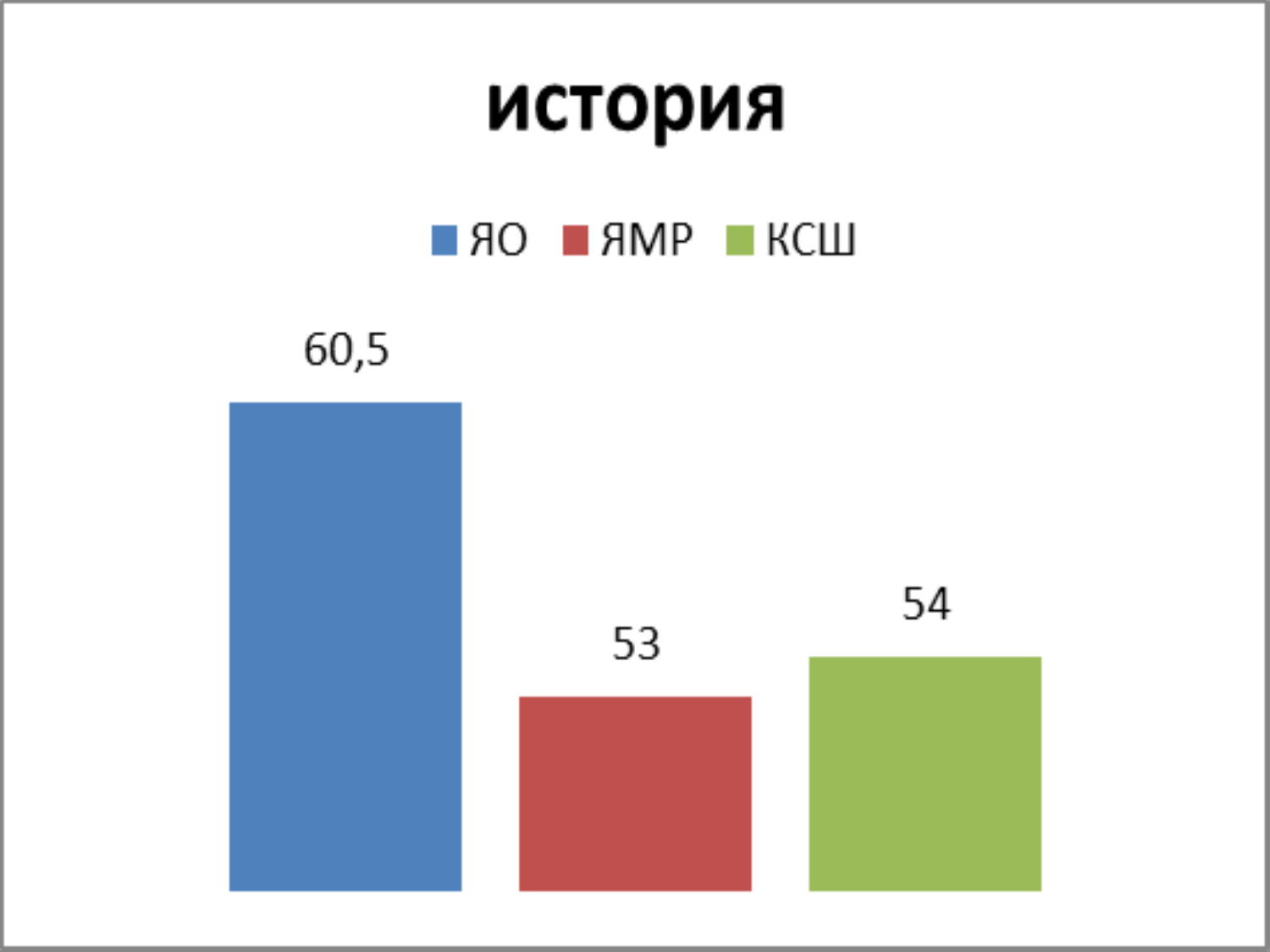
What is the value for ЯМР? 53 What is the title of the chart? история Which category has the highest value? ЯО What is the difference between the values for КСШ and ЯМР? 1 What is the value for ЯО? 60,5 What is the difference between the values for ЯО and ЯМР? 7,5 What is the value for КСШ? 54 Which category has the lowest value? ЯМР How many entries does the legend list? 3 What kind of chart is shown on the slide? bar chart Which is larger, the value for ЯО or the value for КСШ? ЯО How many bars are shown in the chart? 3